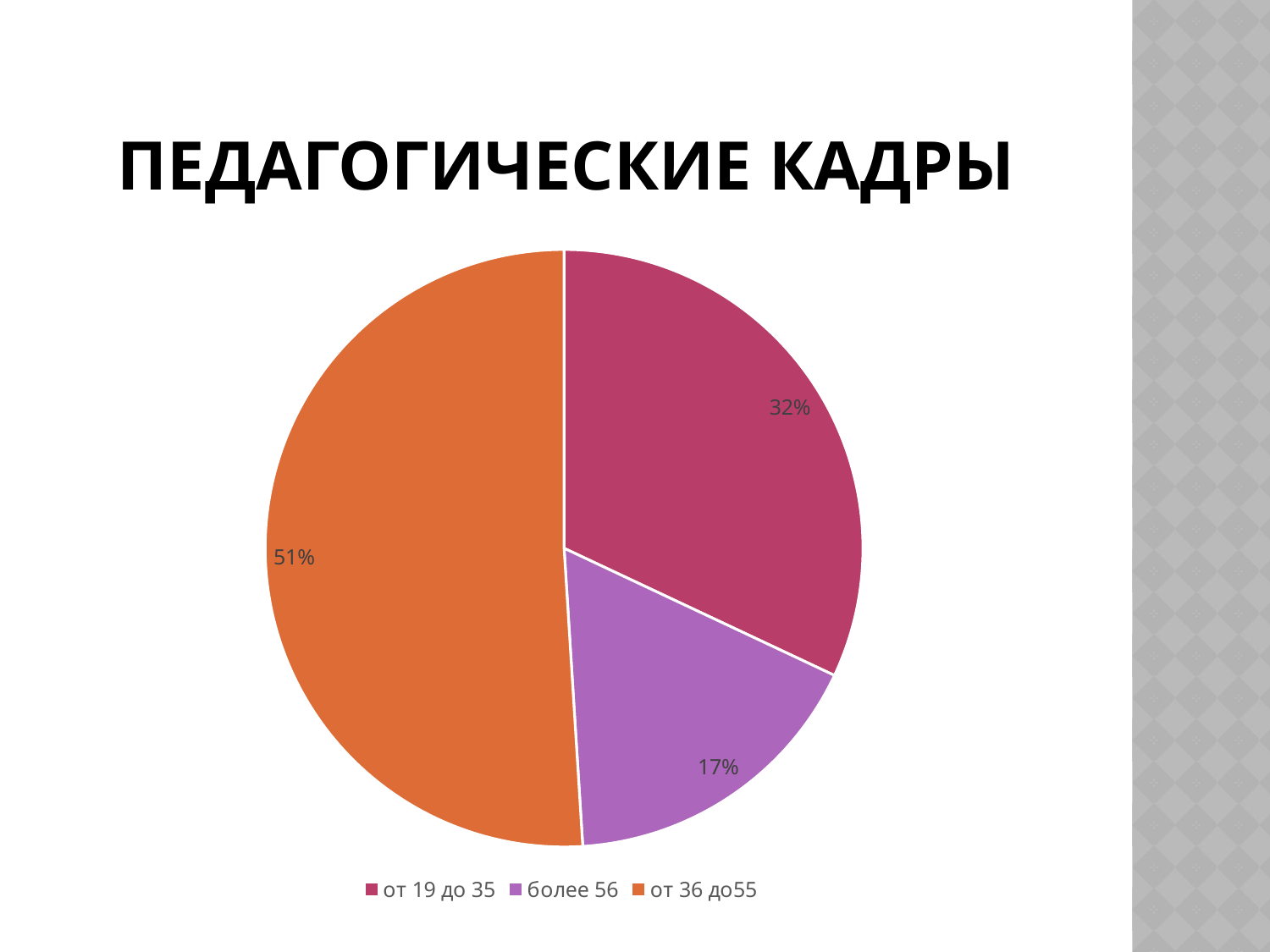
What type of chart is shown on the slide? pie chart Which is larger, the "от 19 до 35" slice or the "более 56" slice? от 19 до 35 Which category has the smallest slice of the pie? более 56 How many slices does the pie chart have? 3 What share of the pie does the "от 36 до55" slice represent? 51% How many entries does the legend list? 3 Which category has the largest slice of the pie? от 36 до55 What is the title of the chart? ПЕДАГОГИЧЕСКИЕ КАДРЫ What share of the pie does the "более 56" slice represent? 17% What is the difference in percentage points between the "от 36 до55" slice and the "от 19 до 35" slice? 19% What share of the pie does the "от 19 до 35" slice represent? 32% What colour is the "более 56" slice? purple